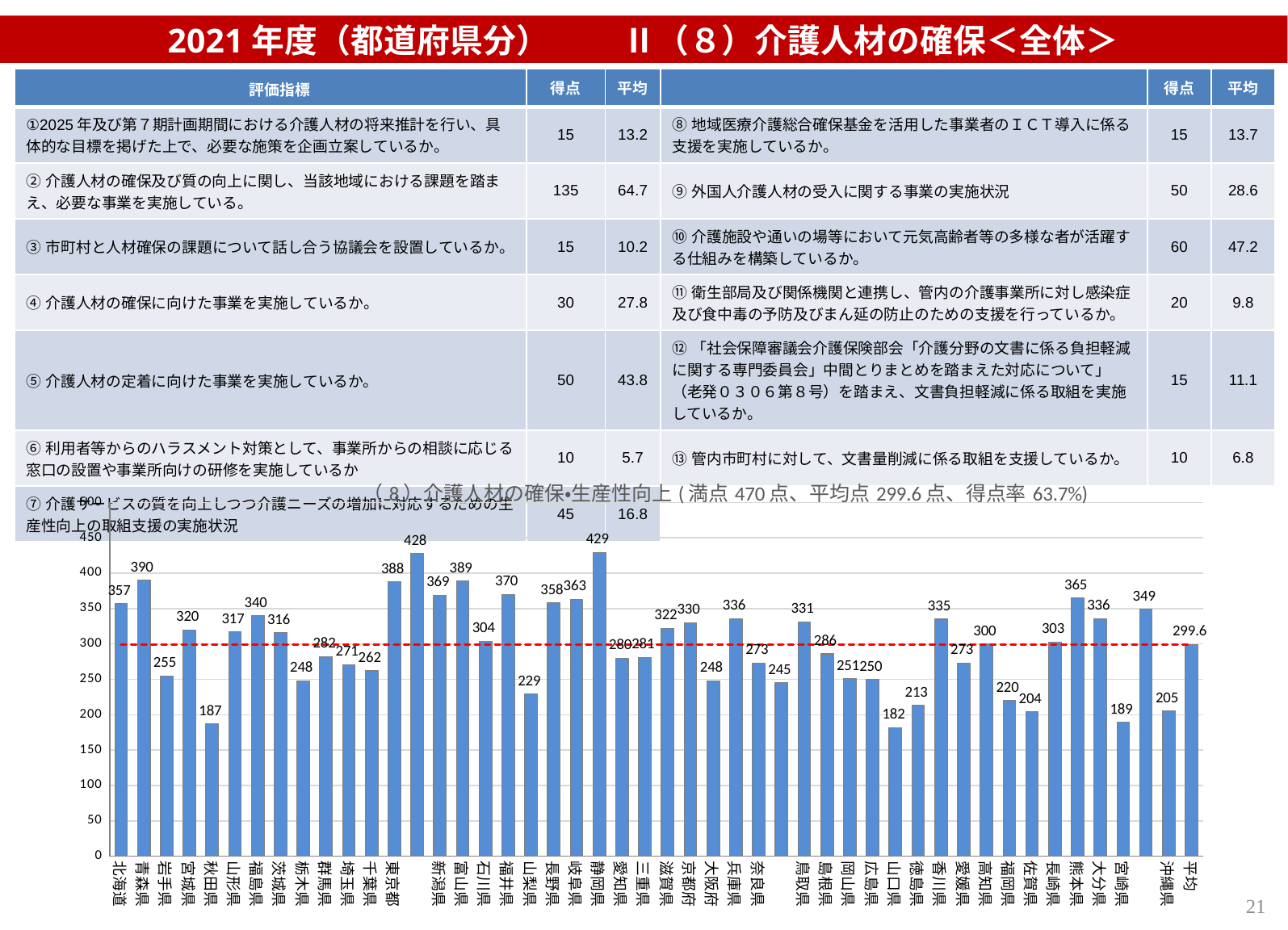
Which has a larger value in the bar chart, 福島県 or 茨城県? 福島県 What kind of chart is shown at the bottom of the slide? bar chart What is the value for 秋田県 in the bar chart? 187 Which labelled prefecture has the lowest value in the bar chart? 山口県 What is the difference between the values for 熊本県 and 宮崎県 in the bar chart? 176 What is the value for 静岡県 in the bar chart? 429 What is the value for 平均 (the last bar) in the bar chart? 299.6 Which prefecture has the highest value in the bar chart? 静岡県 According to the chart title, what is the 満点 (maximum score) for this indicator? 470点 What is the value for 青森県 in the bar chart? 390 Is the value for 徳島県 in the bar chart greater or less than 250? less What is the difference between the values for 東京都 and 山梨県 in the bar chart? 159